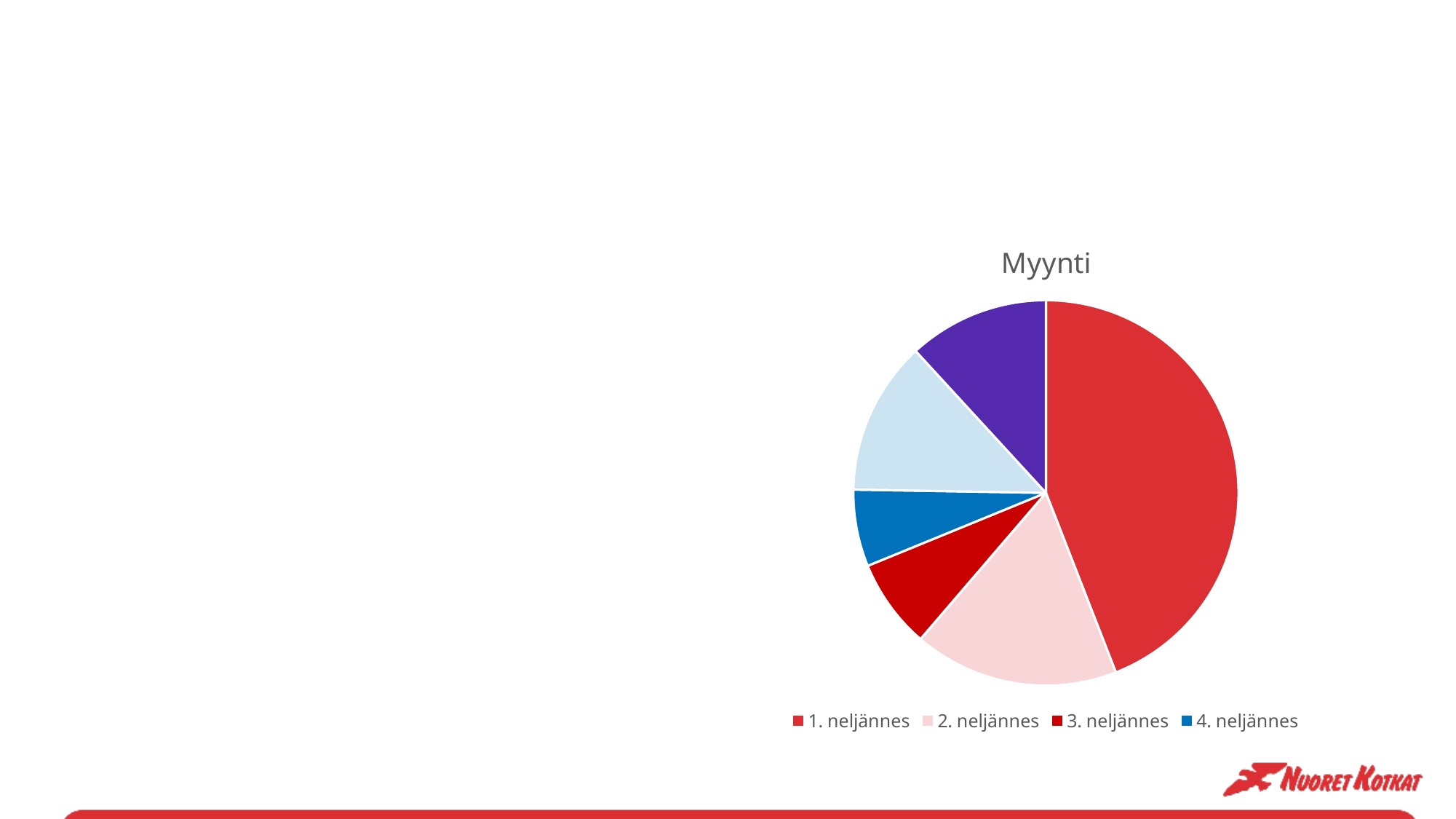
What is the title of the chart? Myynti How many entries does the chart's legend list? 4 Which slice is larger, 2. neljännes or 3. neljännes? 2. neljännes Which slice is larger, 1. neljännes or 2. neljännes? 1. neljännes How many slices does the pie chart have? 6 What colour is the slice for 1. neljännes? red Which legend category has the largest slice of the pie? 1. neljännes Which slice is larger, 2. neljännes or 4. neljännes? 2. neljännes What kind of chart is shown on the slide? pie chart